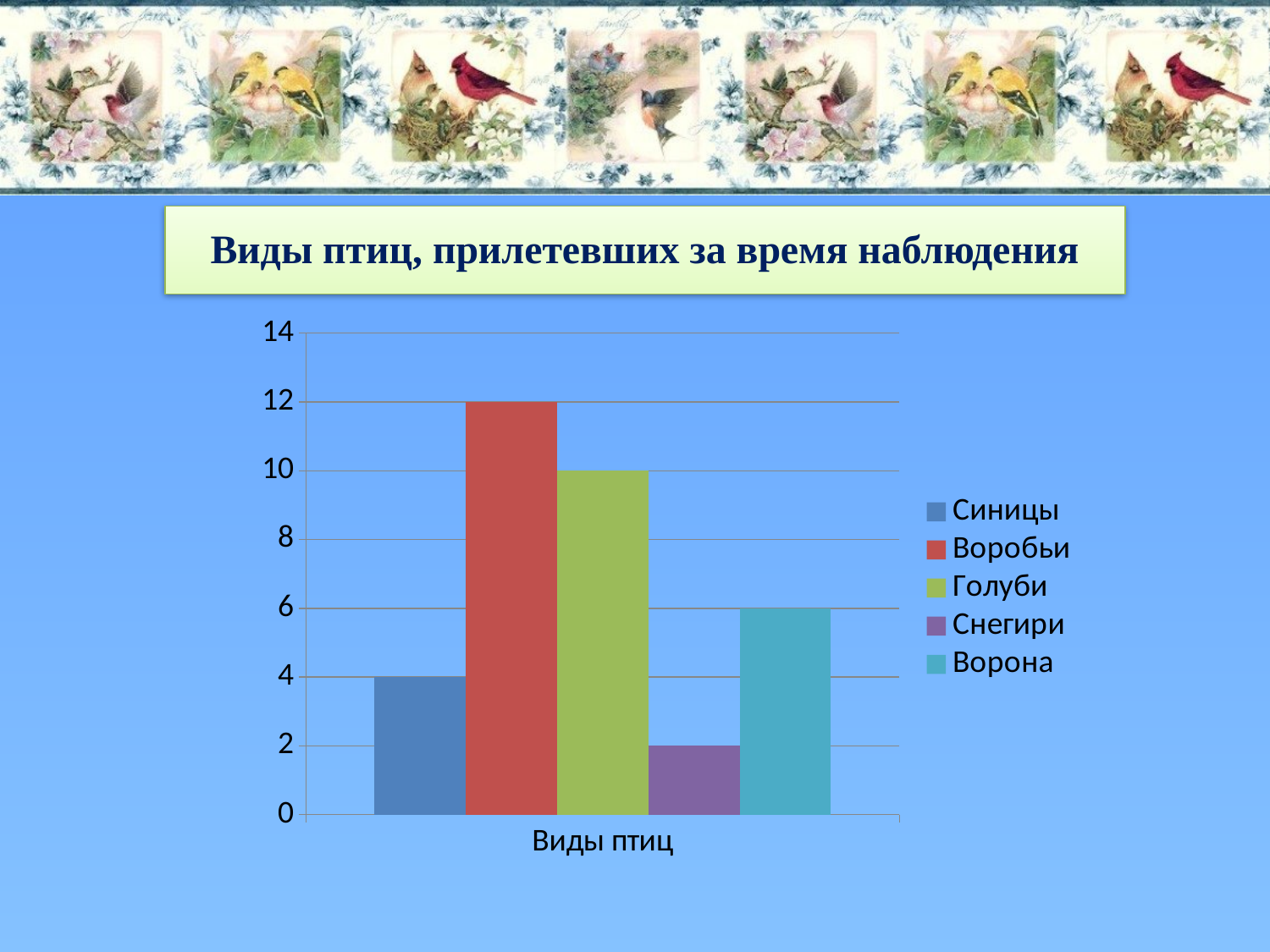
How many series does the legend list? 5 What is the difference between the values for Воробьи and Голуби? 2 Which is larger, the value for Ворона or the value for Синицы? Ворона What is the value for Синицы? 4 Which series has the highest value? Воробьи What is the title of the chart? Виды птиц, прилетевших за время наблюдения What kind of chart is shown on the slide? bar chart Is the value for Голуби greater or less than 8? greater What is the value for Ворона? 6 What colour is the bar for Голуби? green What is the value for Воробьи? 12 Which series has the lowest value? Снегири